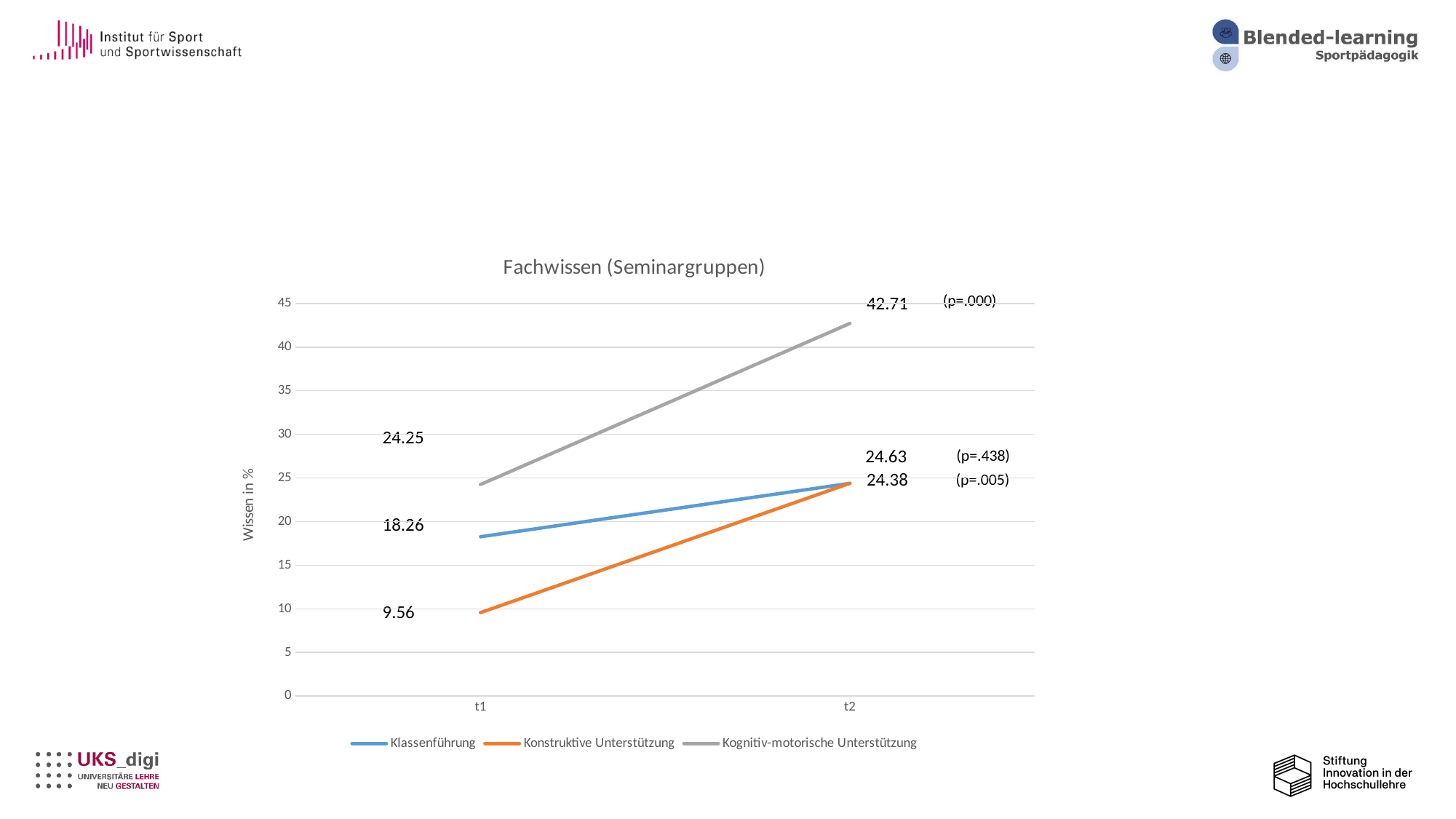
What is the value for Kognitiv-motorische Unterstützung at t2? 42.71 What is the title of the chart? Fachwissen (Seminargruppen) What kind of chart is shown on the slide? line chart What is the value for Klassenführung at t1? 18.26 Which series has the lowest value at t1? Konstruktive Unterstützung Which series has the highest value at t2? Kognitiv-motorische Unterstützung What is the label of the y axis? Wissen in % What is the value for Konstruktive Unterstützung at t1? 9.56 Does the value for Klassenführung rise or fall from t1 to t2? rise How many series does the legend list? 3 How many time points are shown on the x axis? 2